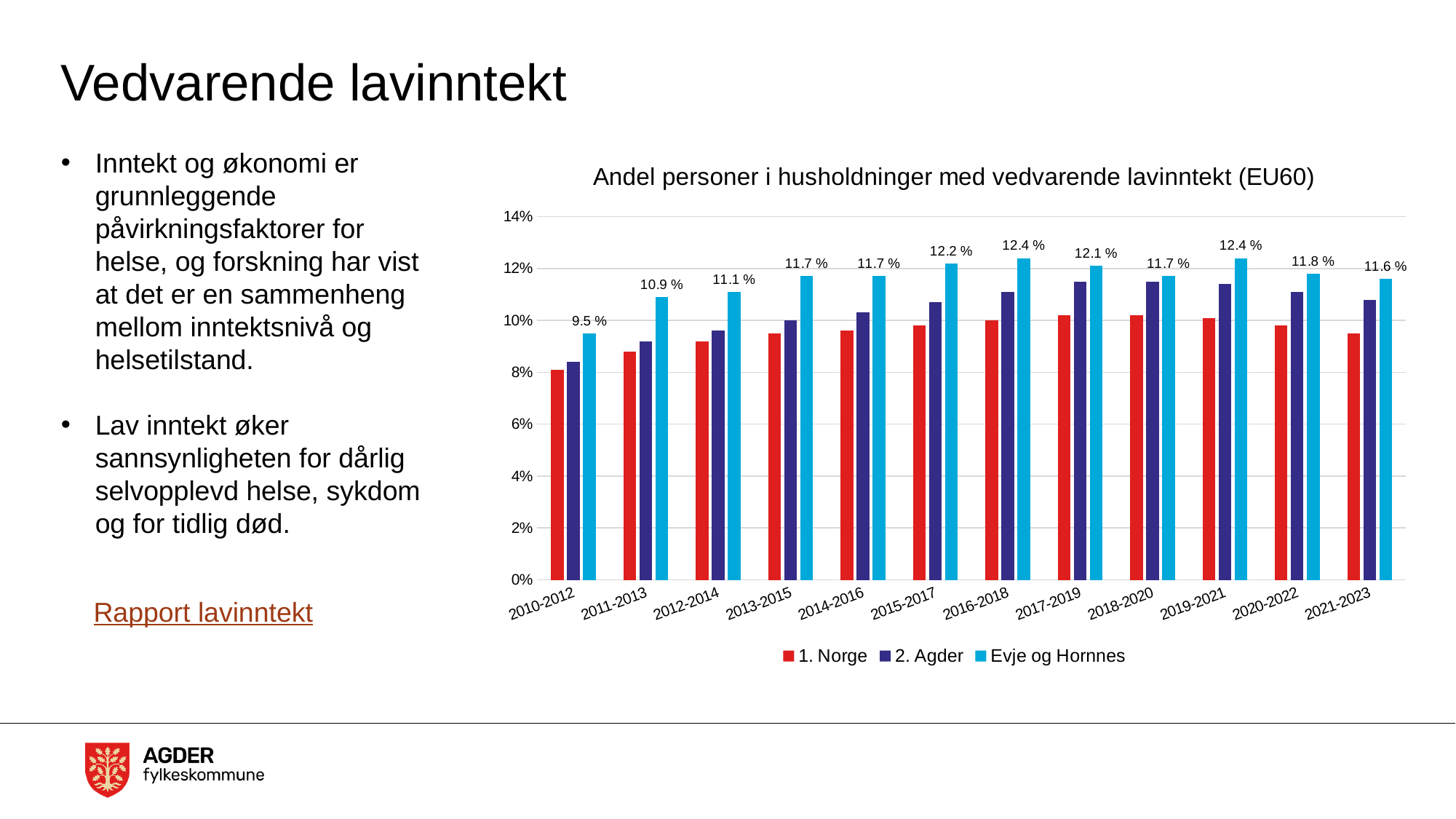
Is the value for 2. Agder in 2021-2023 greater or less than 10%? greater Is the value for 1. Norge in 2021-2023 greater or less than 10%? less In 2016-2018, which is larger: the value for 1. Norge or for Evje og Hornnes? Evje og Hornnes What kind of chart is shown? Bar chart In which period is the value for Evje og Hornnes lowest? 2010-2012 What is the value for Evje og Hornnes in 2021-2023? 11.6 % What is the value for Evje og Hornnes in 2010-2012? 9.5 % How many periods are shown on the x axis? 12 How many series does the legend list? 3 Do the values for Evje og Hornnes rise or fall from 2010-2012 to 2016-2018? Rise What is the value for Evje og Hornnes in 2015-2017? 12.2 % What is the difference between the Evje og Hornnes values for 2011-2013 and 2010-2012? 1.4 %